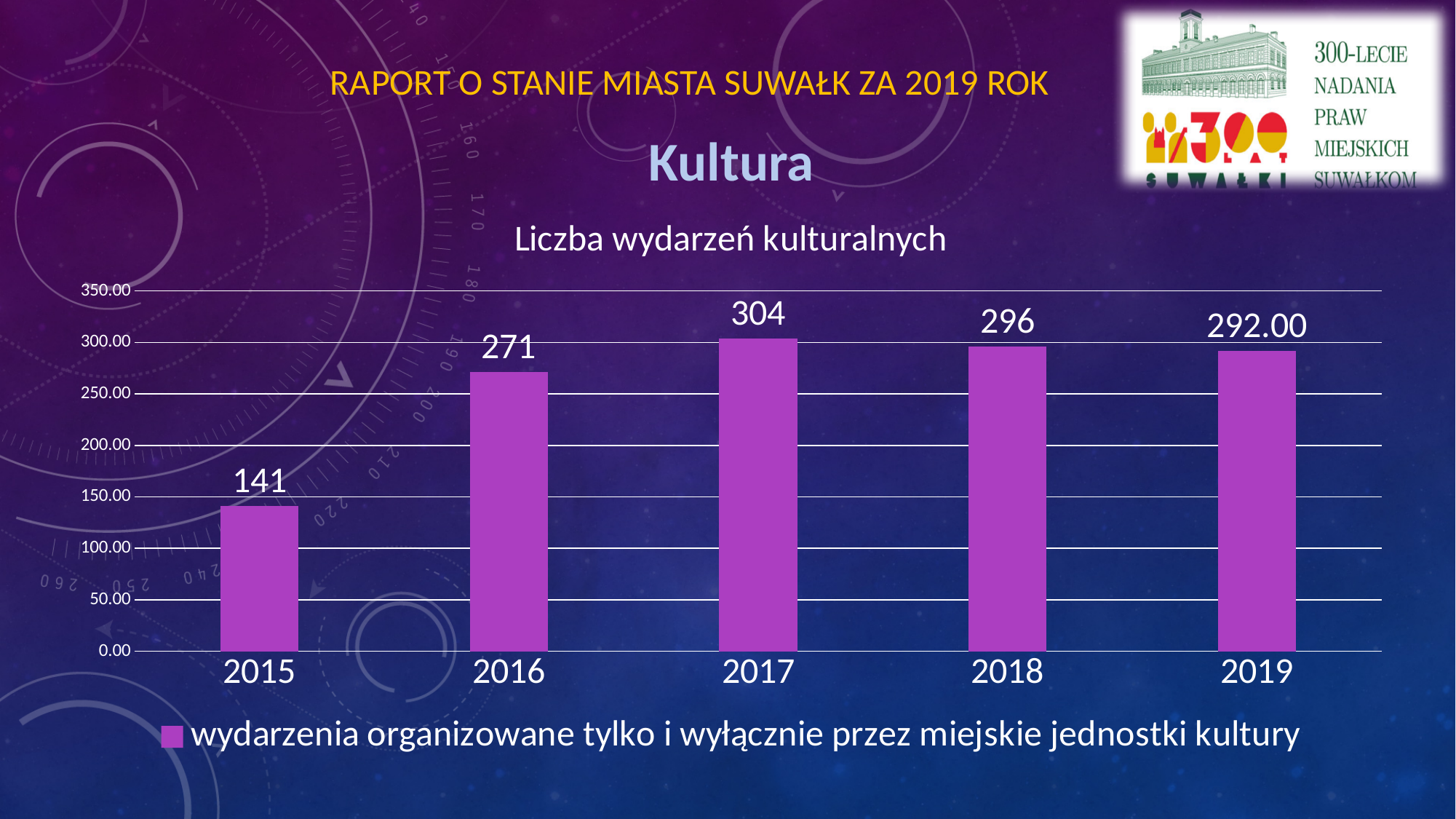
How many years are shown on the x axis? 5 What is the value for 2017? 304 What kind of chart is shown? bar chart Which year has the lowest value? 2015 What is the difference between the values for 2016 and 2015? 130 Is the value for 2015 greater or less than 150.00? less What is the value for 2019? 292.00 Which year has the highest value? 2017 What is the title of the chart? Liczba wydarzeń kulturalnych What is the difference between the values for 2017 and 2018? 8 Which is larger, the value for 2016 or the value for 2018? 2018 What is the value for 2015? 141